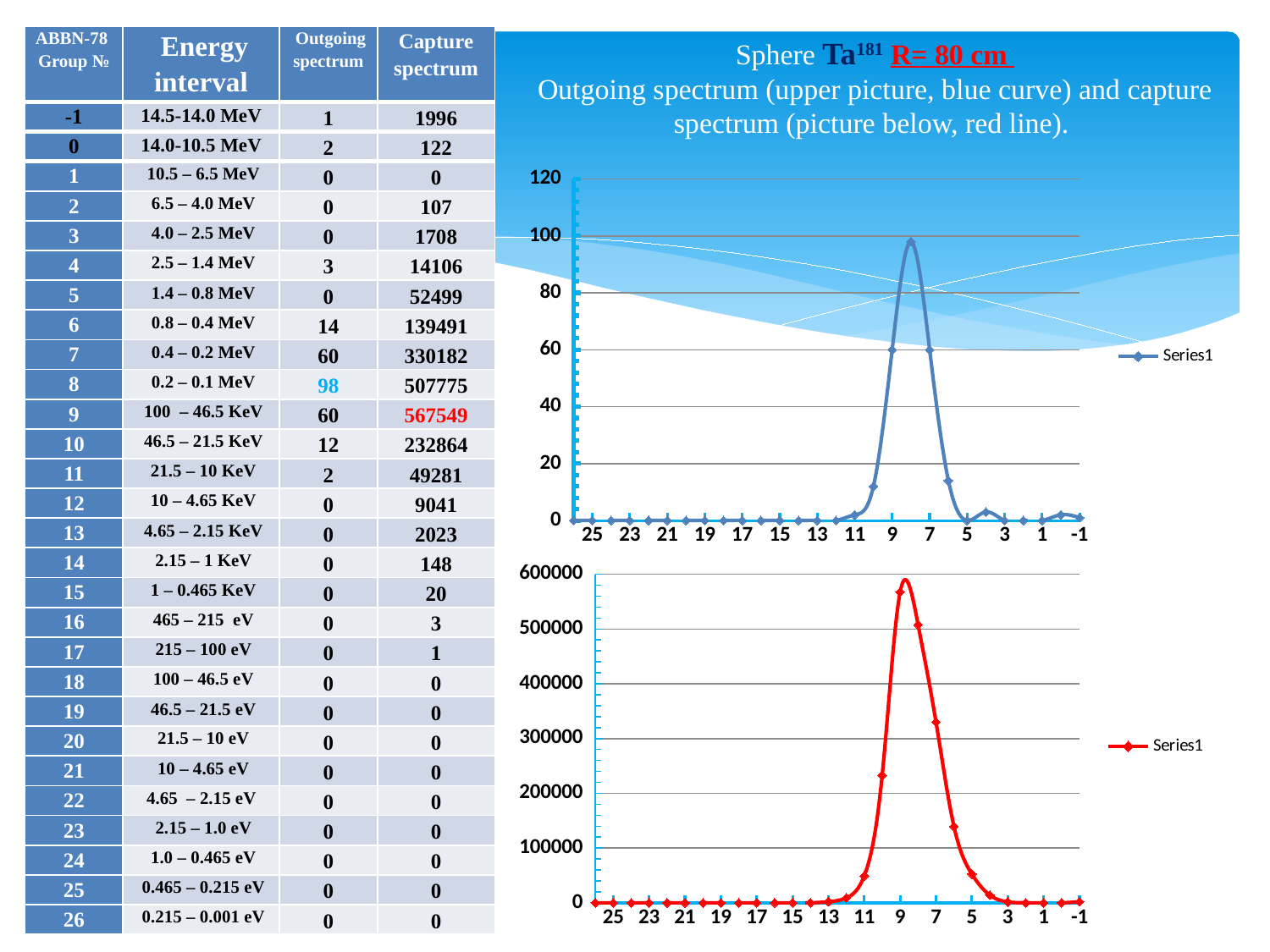
In the upper chart, at which x-axis value does the curve reach its highest point? 8 In the lower chart, is the value at x = 15 greater or less than 100000? less What kind of chart is the upper chart (blue curve)? line chart In the lower chart, is the value at x = 9 greater or less than 500000? greater In the lower chart, at which x-axis value does the curve reach its highest point? 9 In the upper chart, is the value at x = 8 greater or less than 80? greater In the upper chart, how many series does the legend list? 1 In the lower chart, which x value has the larger value: x = 10 or x = 6? 10 In the lower chart, what is the name of the series shown in the legend? Series1 What kind of chart is the lower chart (red curve)? line chart